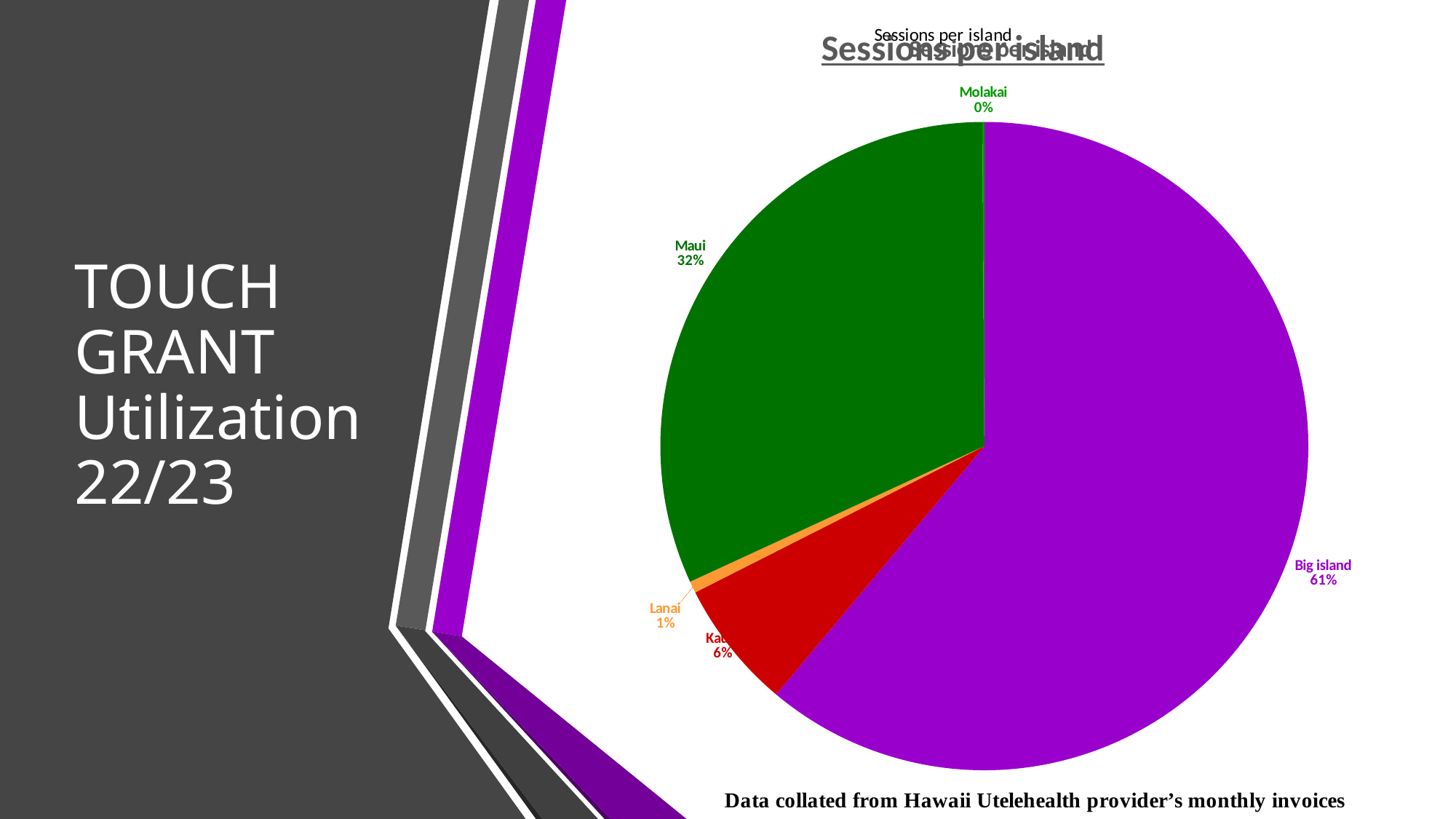
What share of sessions does Big island account for? 61% What share of sessions does Lanai account for? 1% How many percentage points larger is Big island's share than Maui's share? 29 What colour is the Big island slice? purple What share of sessions does Maui account for? 32% How many islands (slices) are shown in the pie chart? 5 Which has a larger share of sessions, Maui or Lanai? Maui Which island has the largest share of sessions? Big island What type of chart is shown on the slide? pie chart What is the title of the chart? Sessions per island Which island has the smallest share of sessions? Molakai